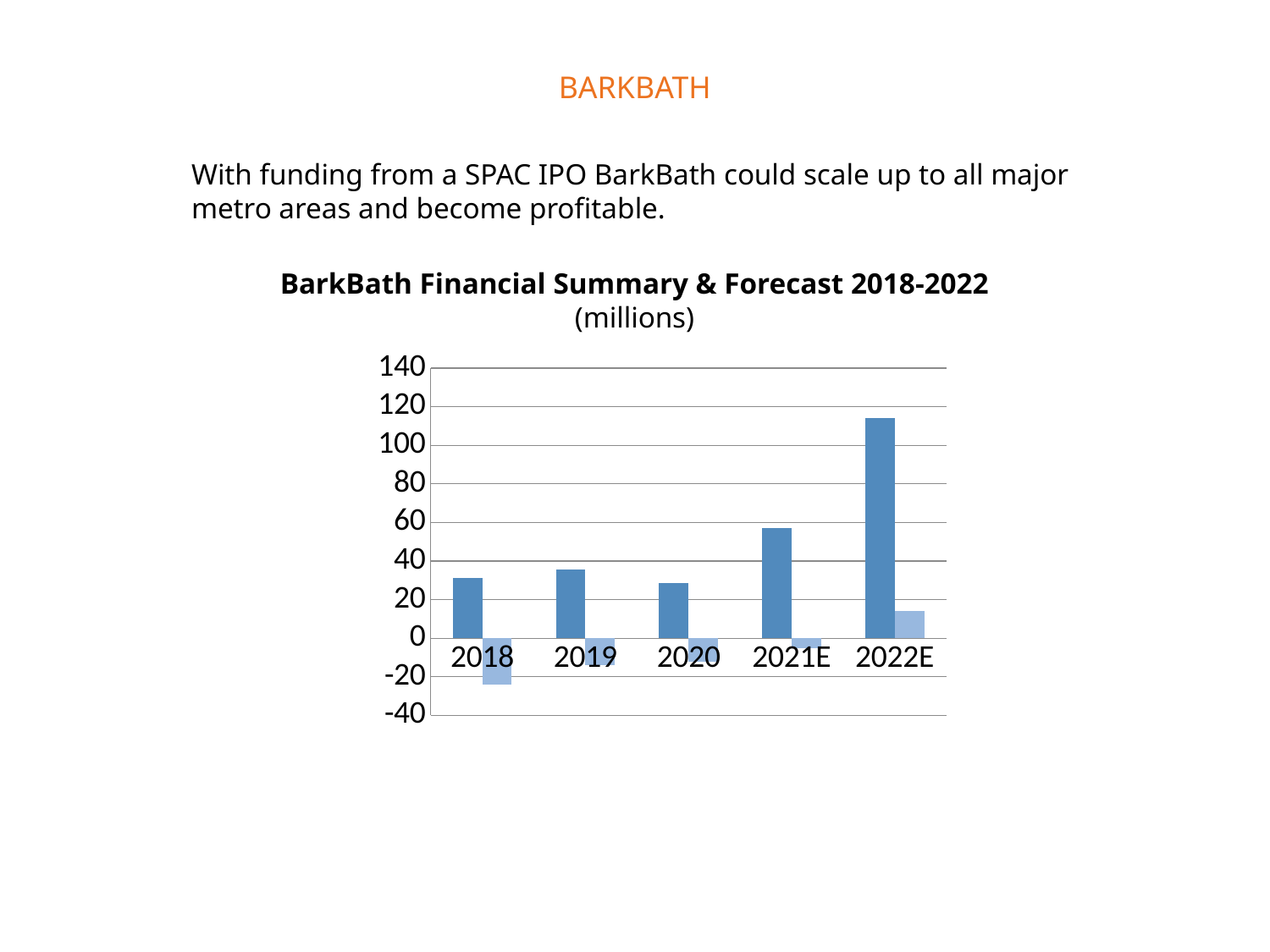
Which category has the lowest light blue bar? 2018 What kind of chart is shown on the slide? bar chart How many categories are shown on the x axis of the chart? 5 What is the title of the chart? BarkBath Financial Summary & Forecast 2018-2022 What unit is stated under the chart title? millions Is the light blue bar for 2022E greater or less than 0? greater Which category has the highest dark blue bar? 2022E Do the light blue bars rise or fall from 2018 to 2022E? rise Is the dark blue bar for 2022E greater or less than 100? greater Which is larger, the dark blue bar for 2019 or the dark blue bar for 2021E? 2021E Is the dark blue bar for 2021E greater or less than 40? greater